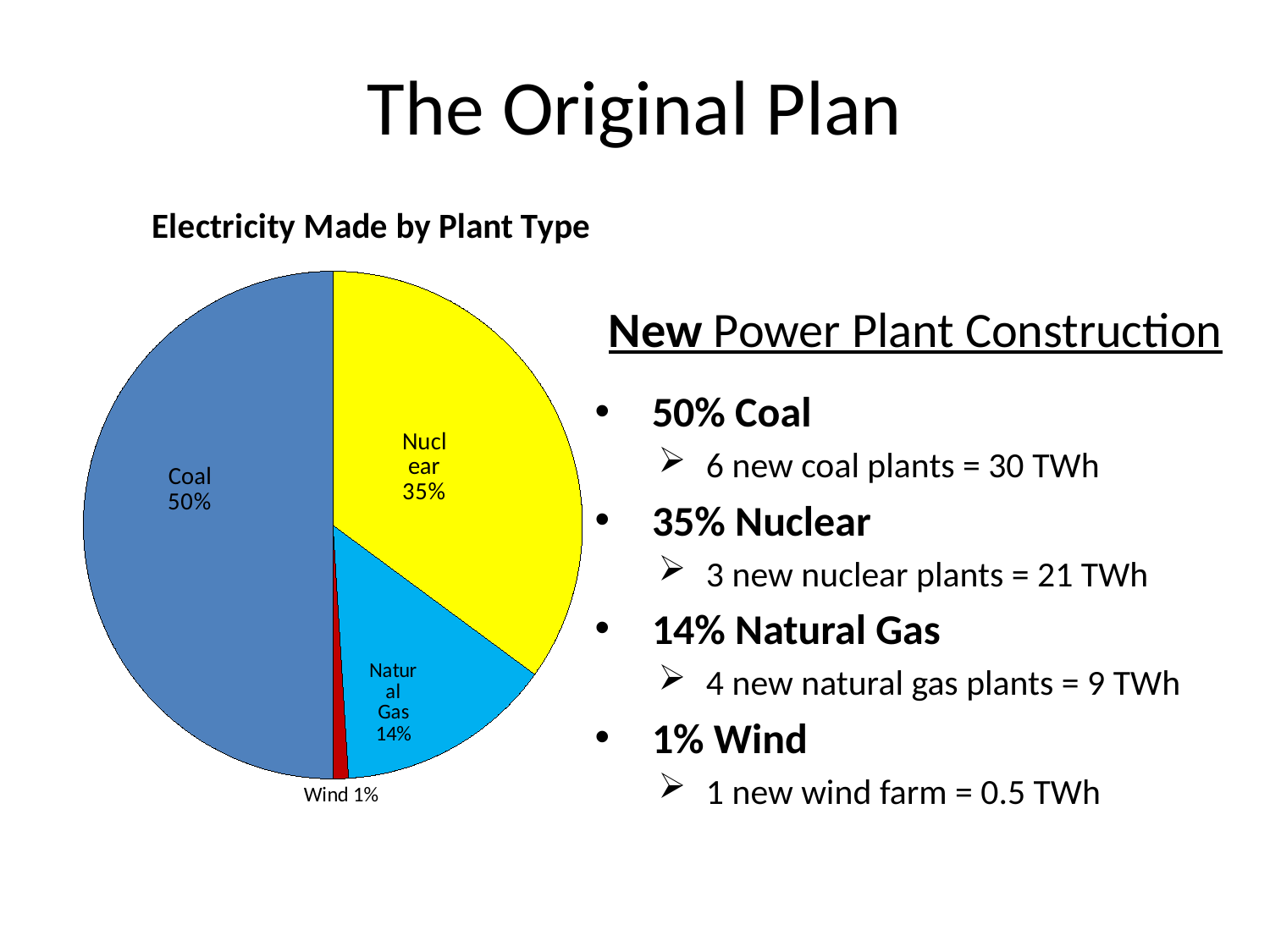
What kind of chart is shown on the slide? Pie chart What share of the pie does Nuclear have? 35% What share of the pie does Wind have? 1% How many slices does the pie chart have? 4 What share of the pie does Coal have? 50% What is the title of the chart? Electricity Made by Plant Type Which plant type has the smallest slice of the pie? Wind What is the difference in percentage points between the Coal and Nuclear slices? 15% Which plant type has the largest slice of the pie? Coal Which slice is larger, Nuclear or Natural Gas? Nuclear What colour is the Nuclear slice? Yellow